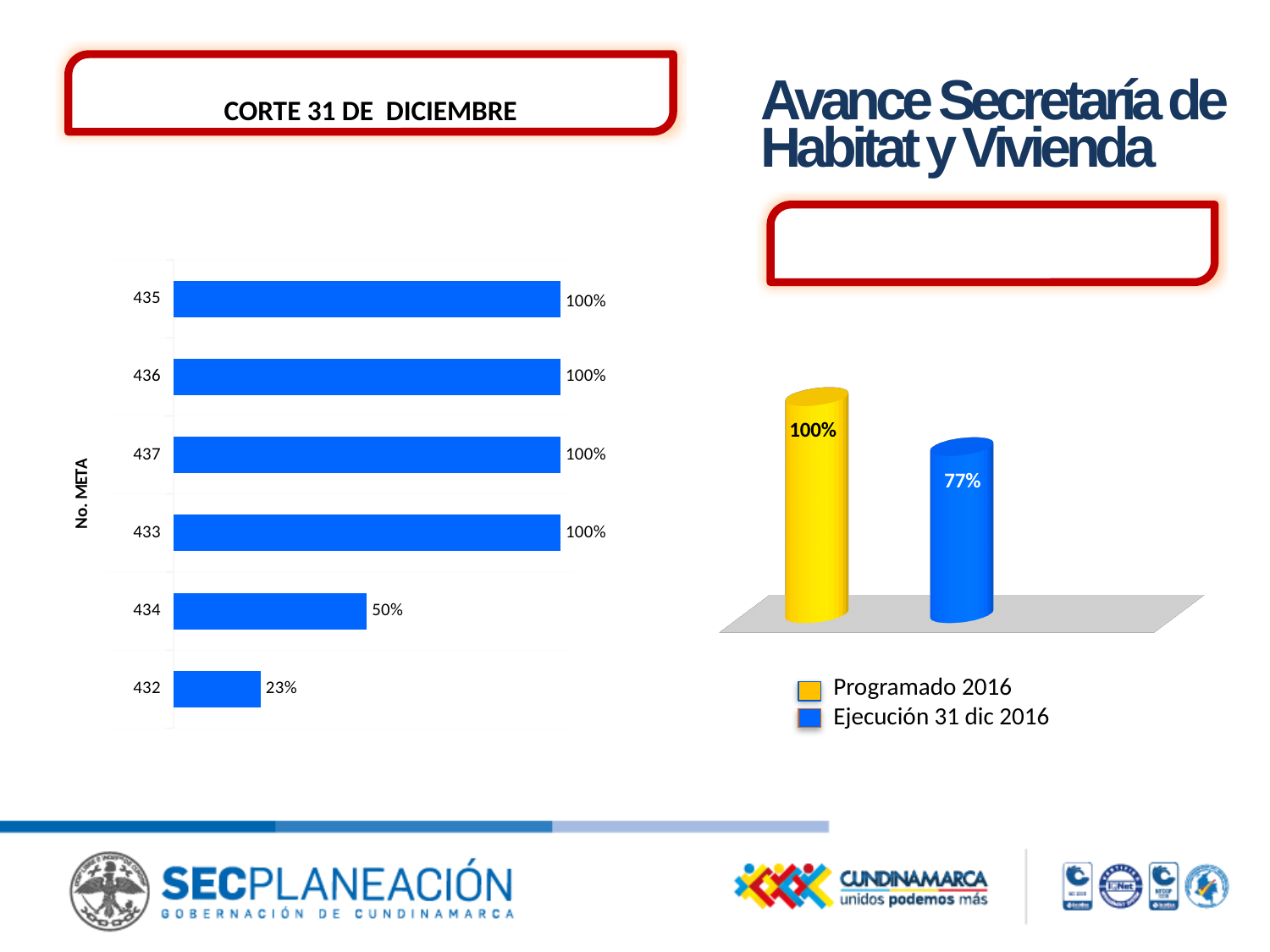
In the left bar chart, which META has the lowest value? 432 How many series does the legend of the right chart list? 2 In the right chart, what is the difference between Programado 2016 and Ejecución 31 dic 2016? 23% In the right chart, what is the value for Ejecución 31 dic 2016? 77% In the left bar chart, which is larger, the value for META 433 or the value for META 434? 433 What kind of chart is the left chart? bar chart In the left bar chart, what is the difference between the values for META 434 and META 432? 27% In the left bar chart, what is the value for META 434? 50% How many META categories are shown in the left bar chart? 6 In the left bar chart, what is the value for META 437? 100% In the right chart, what is the value for Programado 2016? 100% In the left bar chart, what is the value for META 432? 23%